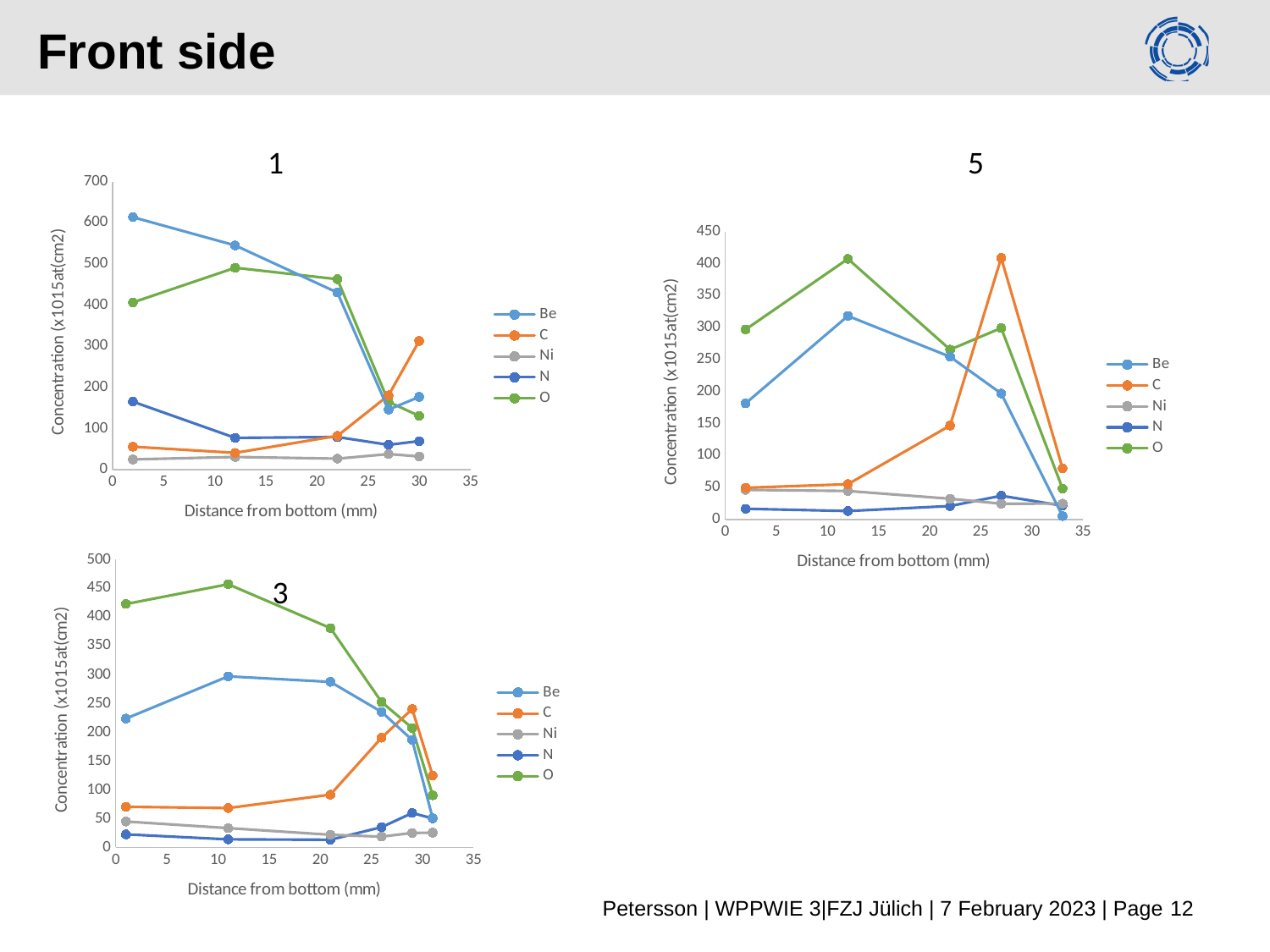
How many series does the legend of the chart titled "5" list? 5 What kind of chart is the chart titled "1"? line chart In the chart titled "1", is the Be value at a distance of 2 mm greater or less than 500? greater In the chart titled "1", how many data points does the Be series have? 5 In the chart titled "5", which series has the highest value at a distance of 27 mm? C In the chart titled "1", does the Be series rise or fall as distance from bottom increases? fall What is the x-axis label of the chart titled "3"? Distance from bottom (mm) In the chart titled "1", which series has the higher value at a distance of 2 mm, Be or O? Be In the chart titled "3", how many data points does the O series have? 6 In the chart titled "3", is the O value at a distance of 11 mm greater or less than 400? greater In the chart titled "5", is the C value at a distance of 27 mm greater or less than 350? greater